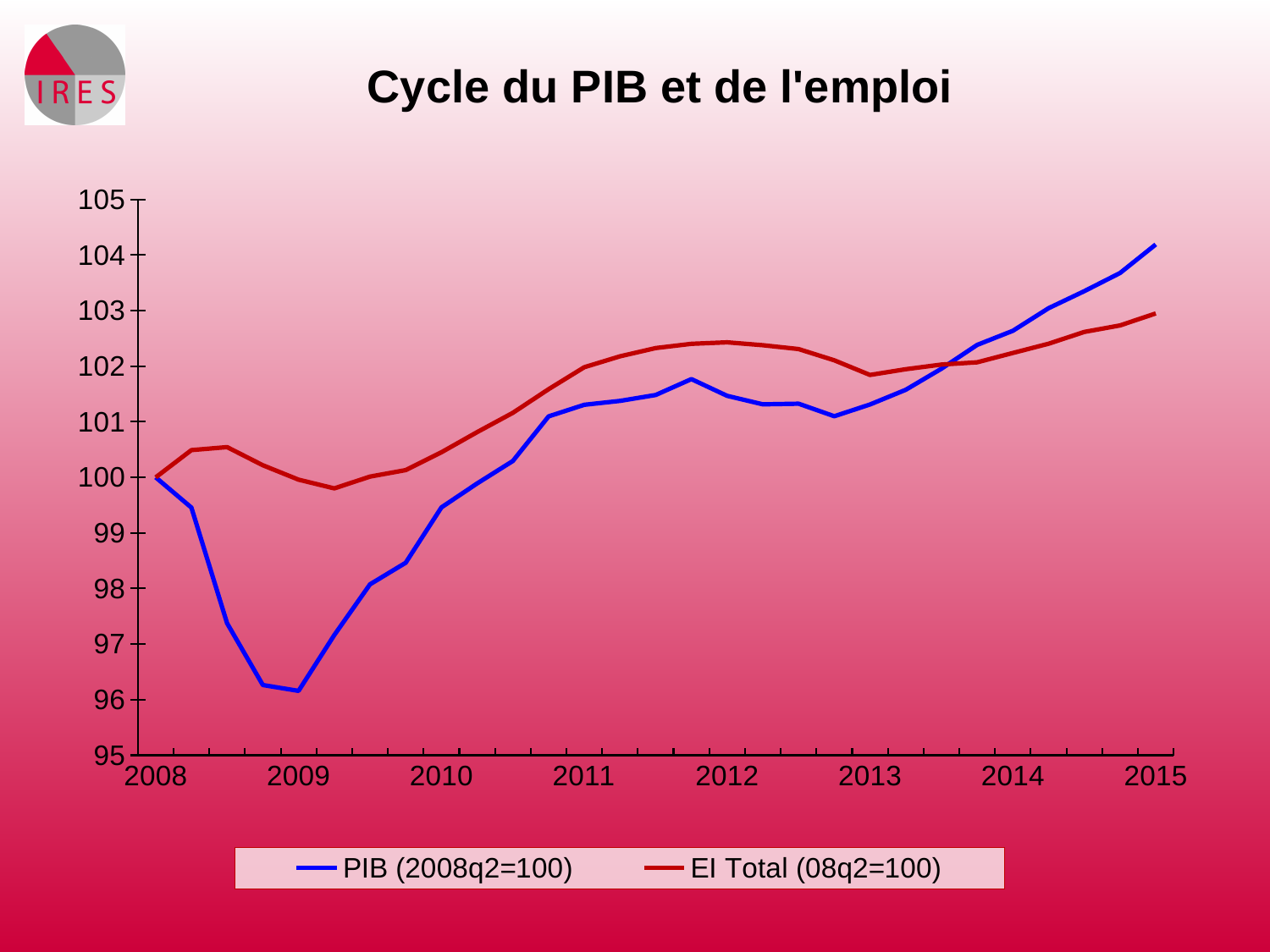
Is the value of EI Total (08q2=100) at 2011 greater or less than 101? greater How many series does the legend list? 2 How many year labels are shown on the x axis? 8 Is the value of EI Total (08q2=100) at 2012 greater or less than 102? greater Is the value of PIB (2008q2=100) at 2009 greater or less than 97? less At what value do both series start in 2008? 100 Which colour is used for the PIB (2008q2=100) series? blue What is the title of the chart? Cycle du PIB et de l'emploi At 2009, which series has the higher value, PIB (2008q2=100) or EI Total (08q2=100)? EI Total (08q2=100) What kind of chart is shown on the slide? line chart At 2015, which series has the higher value, PIB (2008q2=100) or EI Total (08q2=100)? PIB (2008q2=100)